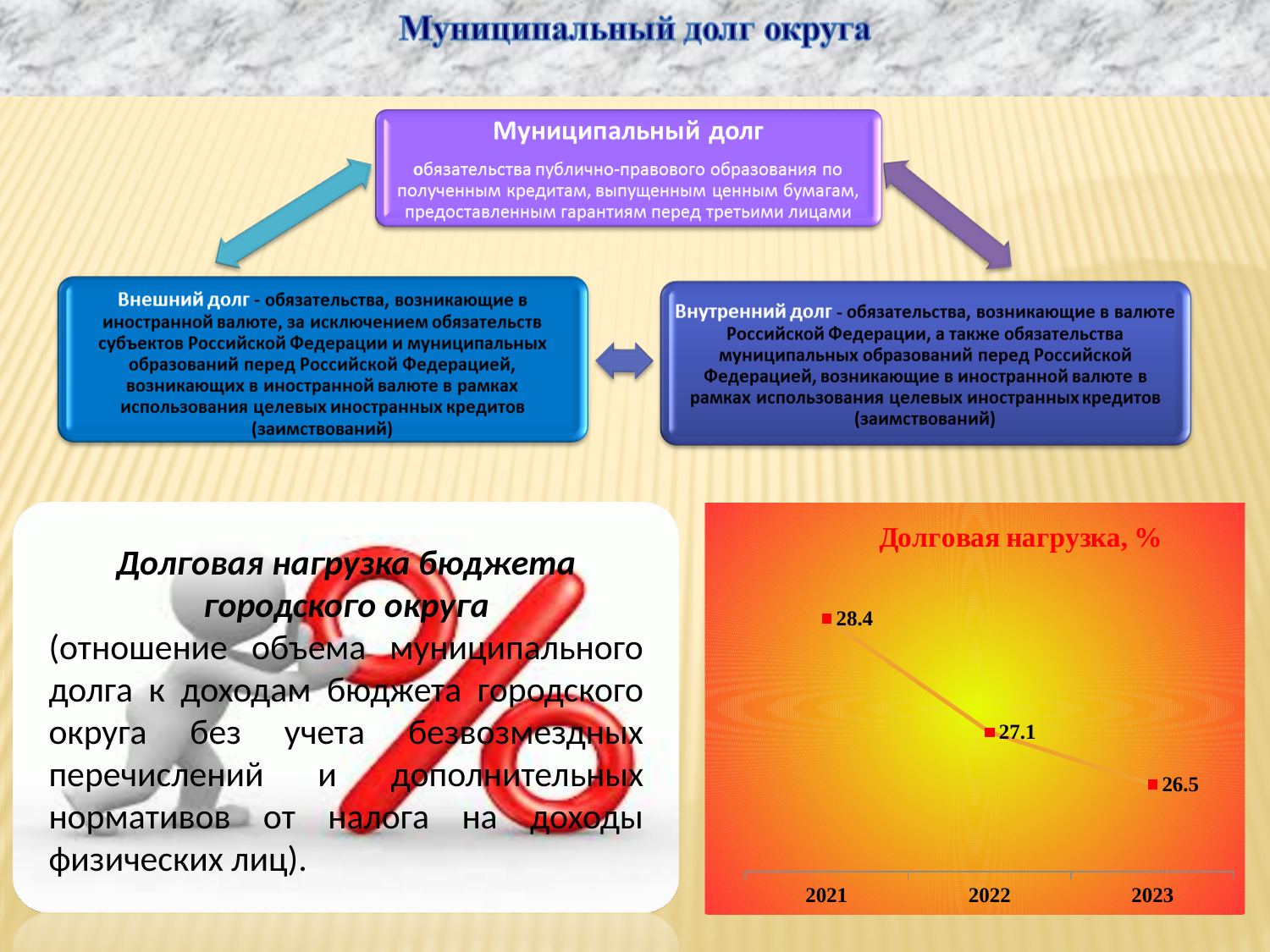
Which year has the highest debt burden value on the chart? 2021 What is the value of the debt burden (Долговая нагрузка, %) for 2022? 27.1 How many years (data points) are shown on the debt burden chart? 3 What is the title of the chart on the slide? Долговая нагрузка, % What is the difference between the debt burden values for 2021 and 2023? 1.9 What is the difference between the debt burden values for 2021 and 2022? 1.3 What kind of chart is used to show the debt burden? line chart Which is larger, the debt burden value for 2022 or for 2023? 2022 Do the debt burden values rise or fall from 2021 to 2023? fall What is the value of the debt burden (Долговая нагрузка, %) for 2023? 26.5 Which year has the lowest debt burden value on the chart? 2023 What is the value of the debt burden (Долговая нагрузка, %) for 2021? 28.4